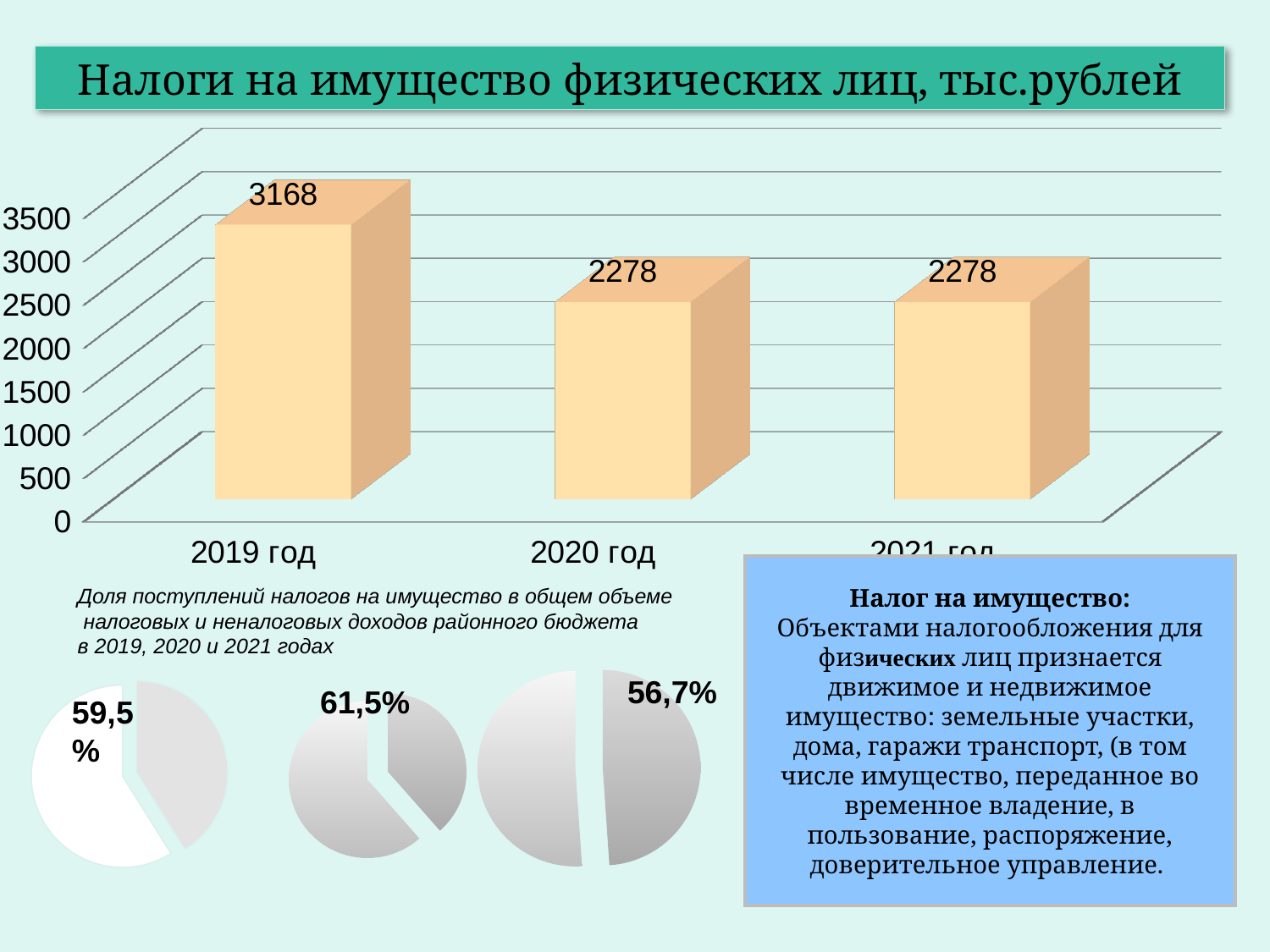
In the bar chart, what is the value for 2021 год? 2278 In the bar chart, is the value for 2020 год greater or less than 2500? less In the bar chart, do the values rise or fall from 2019 год to 2020 год? fall In the bar chart, what is the difference between the values for 2019 год and 2020 год? 890 How many years (categories) are shown in the bar chart? 3 In the bar chart, what is the value for 2020 год? 2278 What kind of chart is the large chart at the top of the slide? bar chart In the bar chart, which is larger: the value for 2019 год or for 2021 год? 2019 год In the bar chart, which year has the highest value? 2019 год In the bar chart, what is the value for 2019 год? 3168 What is the title of the bar chart at the top of the slide? Налоги на имущество физических лиц, тыс.рублей In the bar chart, is the value for 2019 год greater or less than 3000? greater